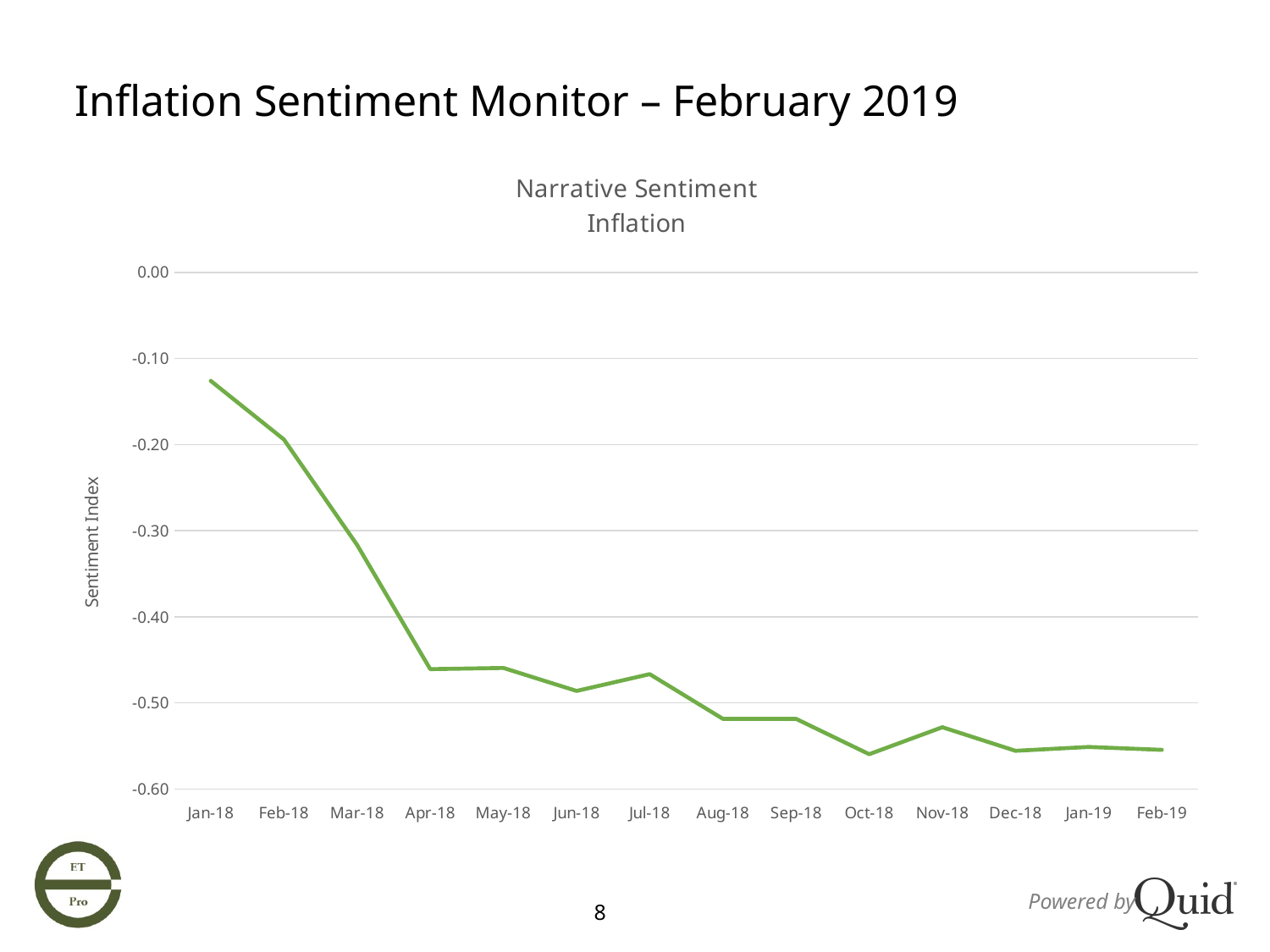
What is the label on the vertical axis of the chart? Sentiment Index Which has the higher sentiment index value, Mar-18 or Apr-18? Mar-18 Is the value for Aug-18 greater or less than -0.50? less Is the value for Apr-18 greater or less than -0.40? less Do the sentiment index values generally rise or fall from Jan-18 to Feb-19? fall Which month has the highest sentiment index value? Jan-18 Is the value for Nov-18 greater or less than -0.50? less How many monthly data points are plotted on the chart? 14 Which has the higher sentiment index value, Jan-18 or Feb-19? Jan-18 What kind of chart is shown on the slide? line chart